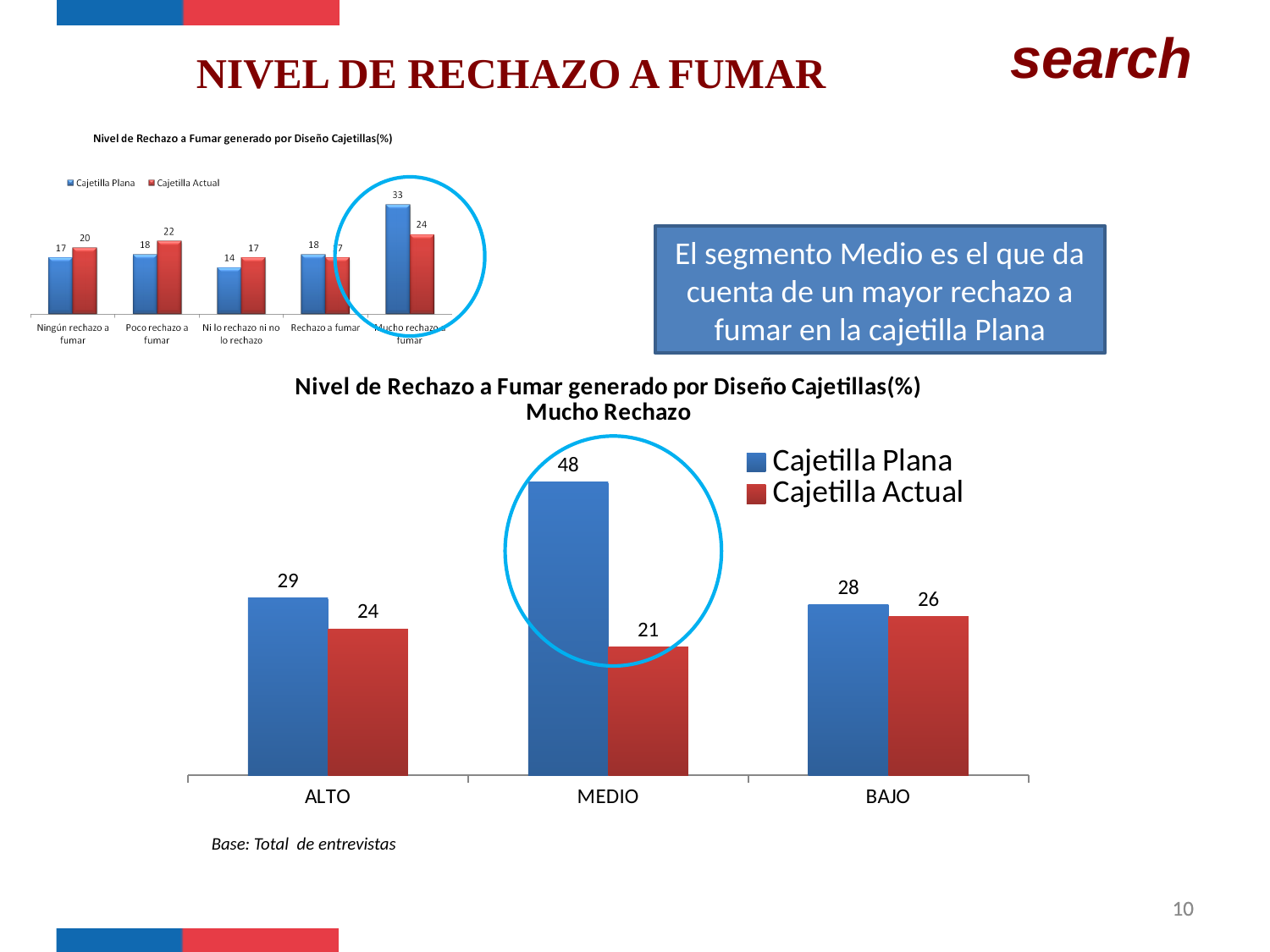
What kind of chart is the large bottom chart (Mucho Rechazo)? Bar chart In the large bottom chart (Mucho Rechazo), which segment has the highest Cajetilla Plana value? MEDIO In the large bottom chart (Mucho Rechazo), what is the difference between Cajetilla Plana and Cajetilla Actual in the MEDIO segment? 27 In the large bottom chart (Mucho Rechazo), which is larger in the ALTO segment: Cajetilla Plana or Cajetilla Actual? Cajetilla Plana In the small top-left chart, what is the Cajetilla Actual value for 'Poco rechazo a fumar'? 22 In the large bottom chart (Mucho Rechazo), what is the value for Cajetilla Actual in the BAJO segment? 26 In the small top-left chart, what is the Cajetilla Plana value for 'Mucho rechazo a fumar'? 33 In the large bottom chart (Mucho Rechazo), which segment has the lowest Cajetilla Actual value? MEDIO In the small top-left chart, which category has the lowest Cajetilla Plana value? Ni lo rechazo ni no lo rechazo How many series does the legend of the large bottom chart (Mucho Rechazo) list? 2 How many segments are shown on the x axis of the large bottom chart (Mucho Rechazo)? 3 In the large bottom chart (Mucho Rechazo), what is the value for Cajetilla Plana in the MEDIO segment? 48